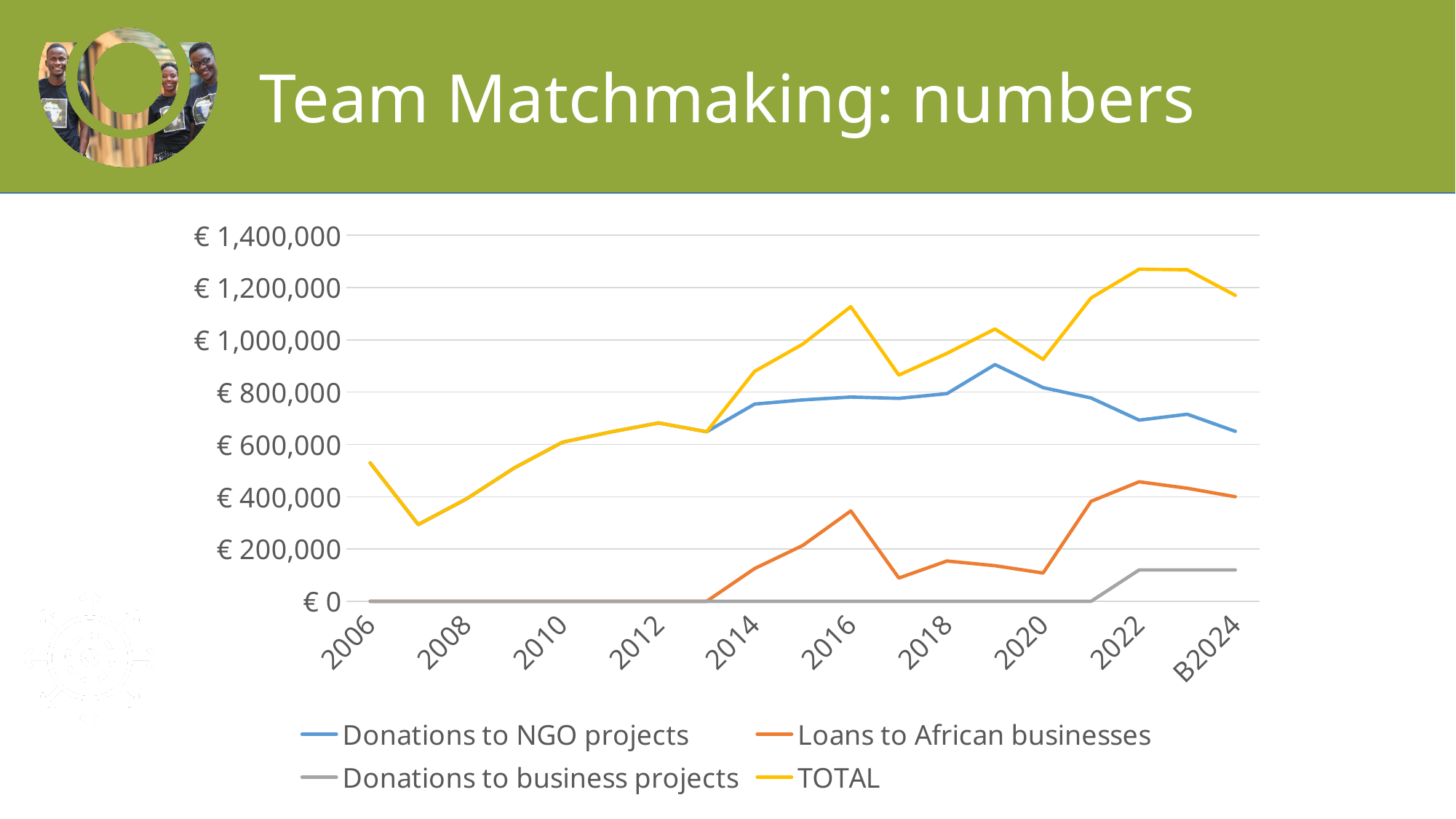
What kind of chart is shown on the slide? line chart How many series does the legend list? 4 Which year has the higher TOTAL value, 2016 or 2017? 2016 In which year is the TOTAL line at its lowest? 2007 Which series is drawn in yellow? TOTAL In which year does Donations to NGO projects reach its highest value? 2019 Is the TOTAL value for 2006 greater or less than € 400,000? greater Is the TOTAL value for 2022 greater or less than € 1,200,000? greater What is the title of the slide containing the chart? Team Matchmaking: numbers Is the value for Donations to NGO projects in 2019 greater or less than € 800,000? greater